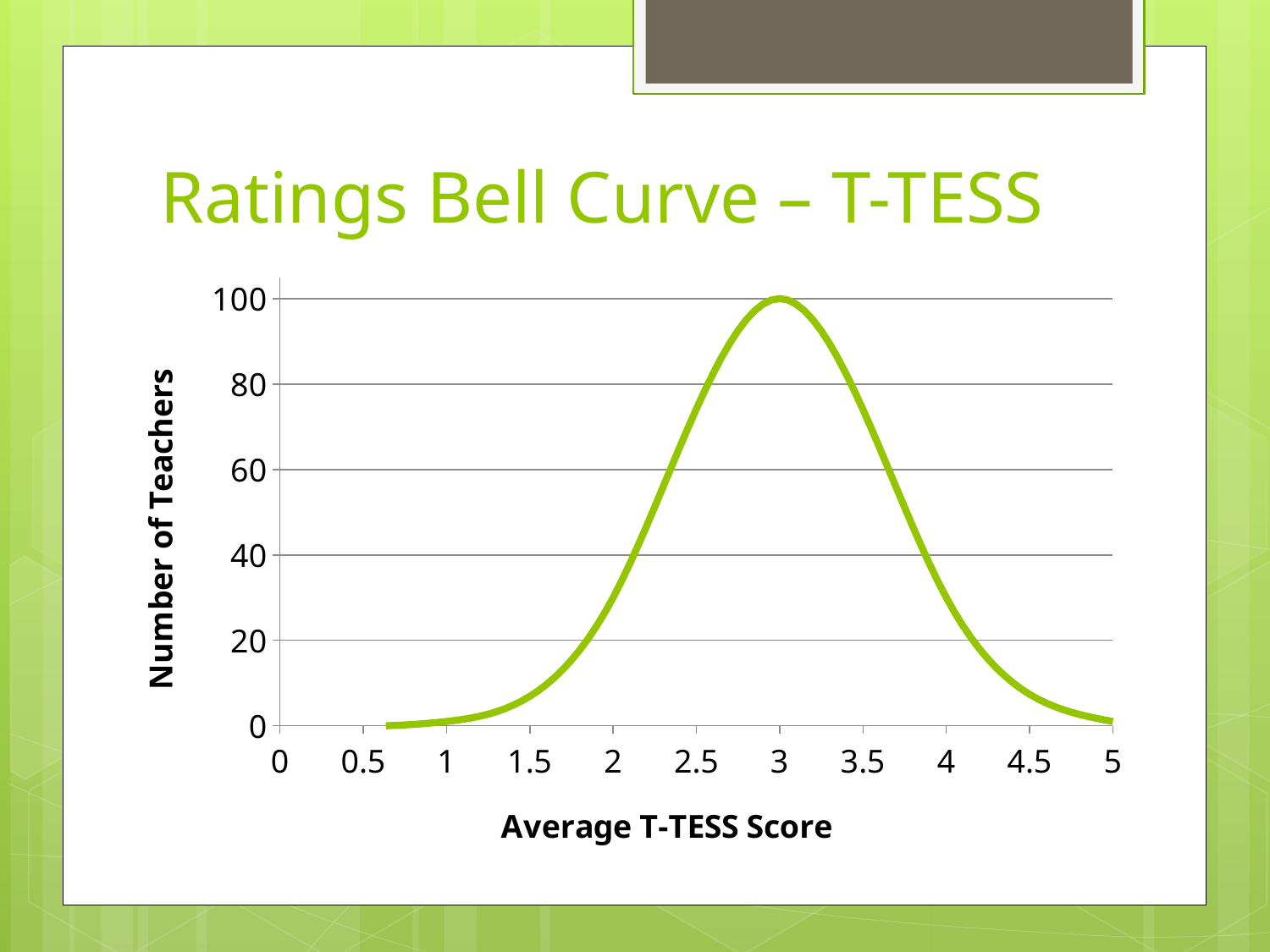
Is the number of teachers at an Average T-TESS Score of 4 greater or less than 40? less What is the title of the chart? Ratings Bell Curve – T-TESS Does the number of teachers rise or fall as the Average T-TESS Score increases from 1 to 3? rise What is the label of the vertical axis? Number of Teachers Is the number of teachers at an Average T-TESS Score of 1.5 greater or less than 20? less What kind of chart is shown on the slide? line chart Which has more teachers: an Average T-TESS Score of 2 or of 3? 3 Is the number of teachers at an Average T-TESS Score of 3.5 greater or less than 60? greater At which Average T-TESS Score does the number of teachers reach its highest point? 3 What is the number of teachers at the peak of the curve, at an Average T-TESS Score of 3? 100 Does the number of teachers rise or fall as the Average T-TESS Score increases from 3 to 5? fall